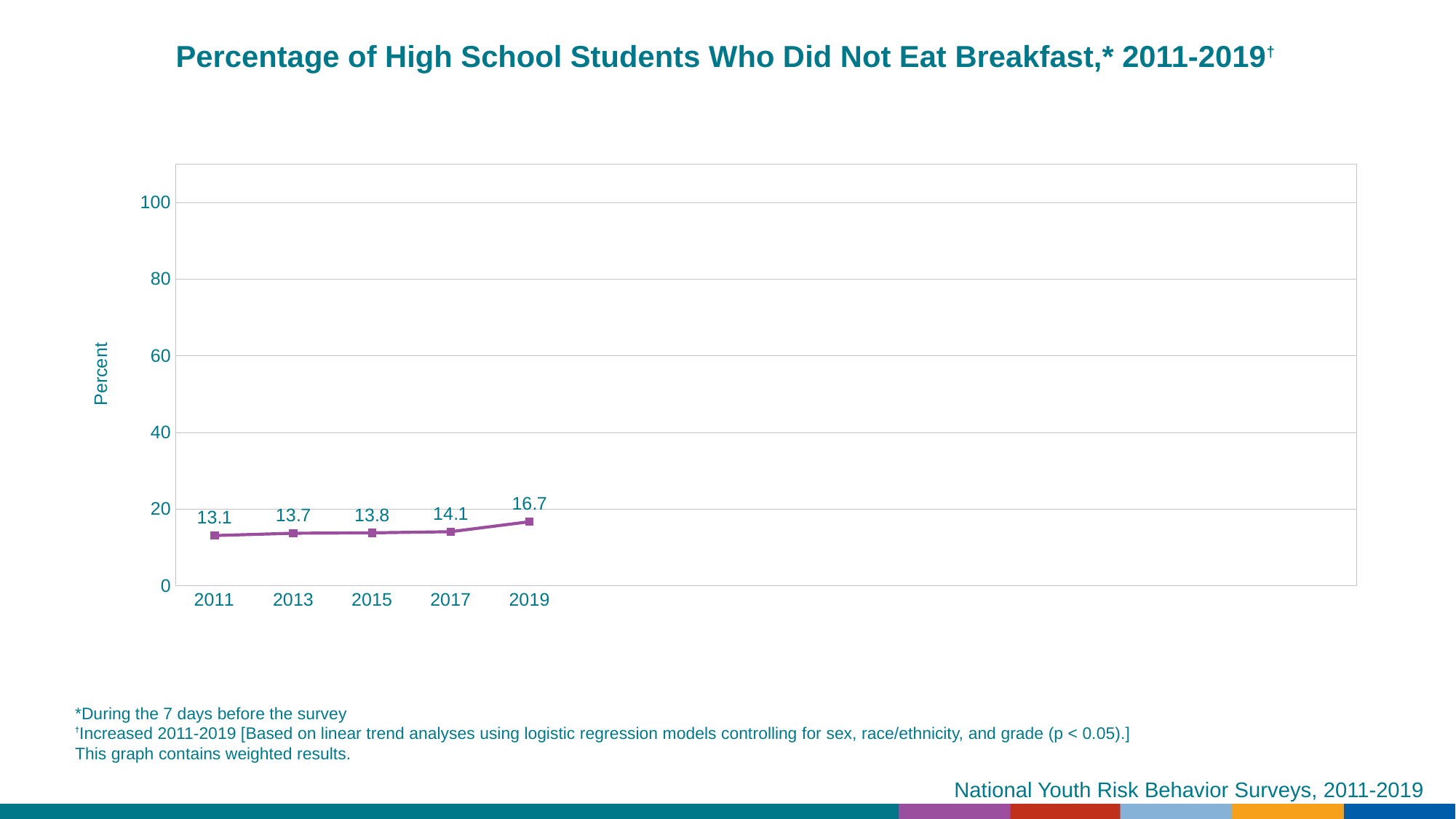
How many years are plotted on the chart? 5 Do the values rise or fall from 2011 to 2019? rise What is the difference between the 2019 value and the 2011 value? 3.6 Which year has the lowest percentage of students who did not eat breakfast? 2011 What percentage of high school students did not eat breakfast in 2011? 13.1 What is the difference between the 2017 value and the 2013 value? 0.4 Which year has the highest percentage of students who did not eat breakfast? 2019 What is the value plotted for 2019? 16.7 What is the value plotted for 2015? 13.8 Which is larger, the value for 2019 or the value for 2017? 2019 Is the value for 2019 greater or less than 20? less What kind of chart is shown on the slide? line chart